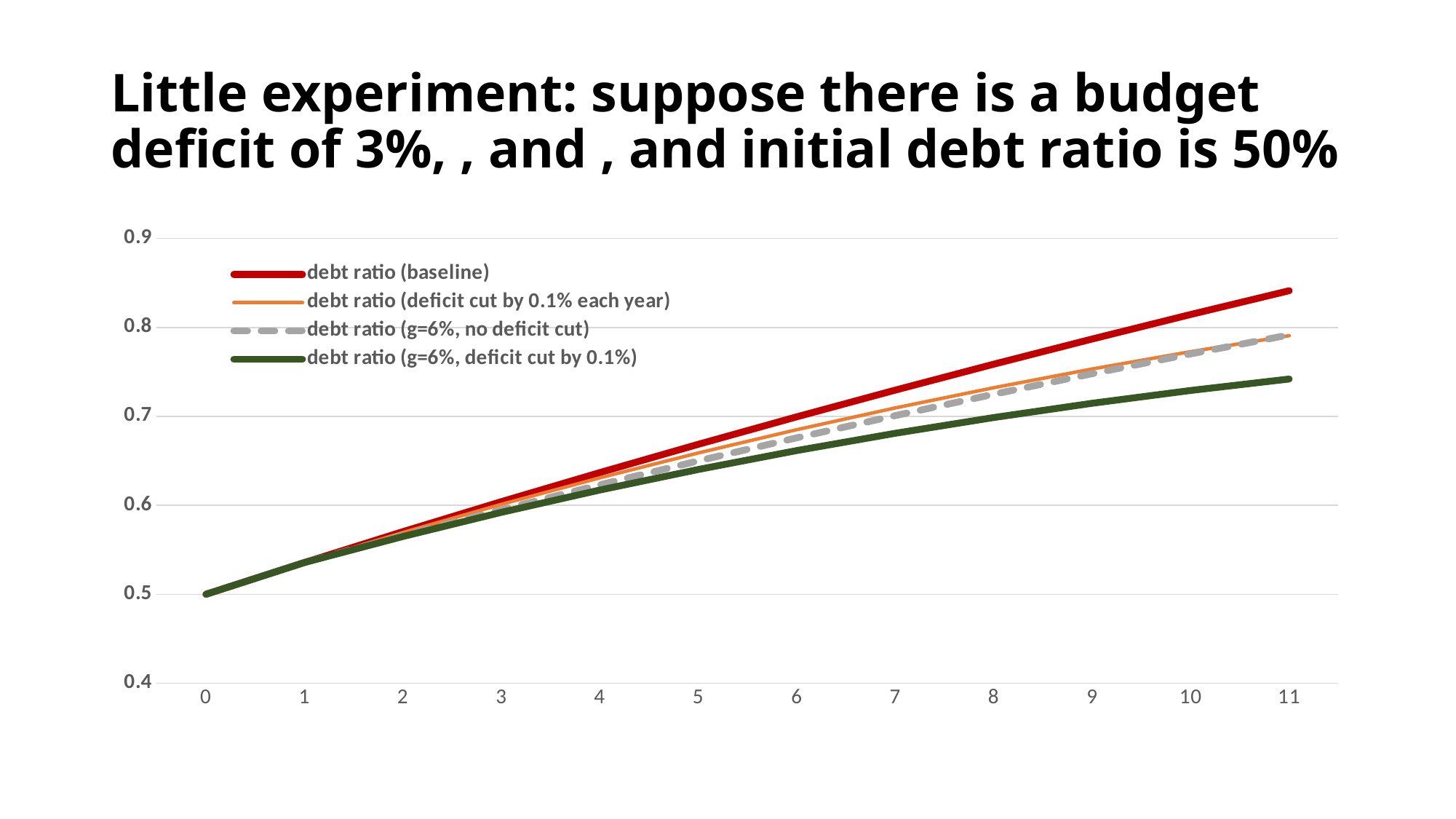
Is the value of the debt ratio (baseline) series at x = 5 greater or less than 0.6? greater How many series does the legend list? 4 Which series has the highest value at x = 11? debt ratio (baseline) Which legend entry is drawn as a dashed line? debt ratio (g=6%, no deficit cut) Which series has the lowest value at x = 11? debt ratio (g=6%, deficit cut by 0.1%) What is the value of the debt ratio (baseline) series at x = 0? 0.5 Is the value of the debt ratio (g=6%, deficit cut by 0.1%) series at x = 11 greater or less than 0.8? less At x = 11, which is larger: the debt ratio (baseline) or the debt ratio (g=6%, deficit cut by 0.1%)? debt ratio (baseline) Do the values of the debt ratio (baseline) series rise or fall along the x axis? rise What kind of chart is shown on the slide? line chart Is the value of the debt ratio (baseline) series at x = 11 greater or less than 0.8? greater How many points along the x axis does each line cover? 12